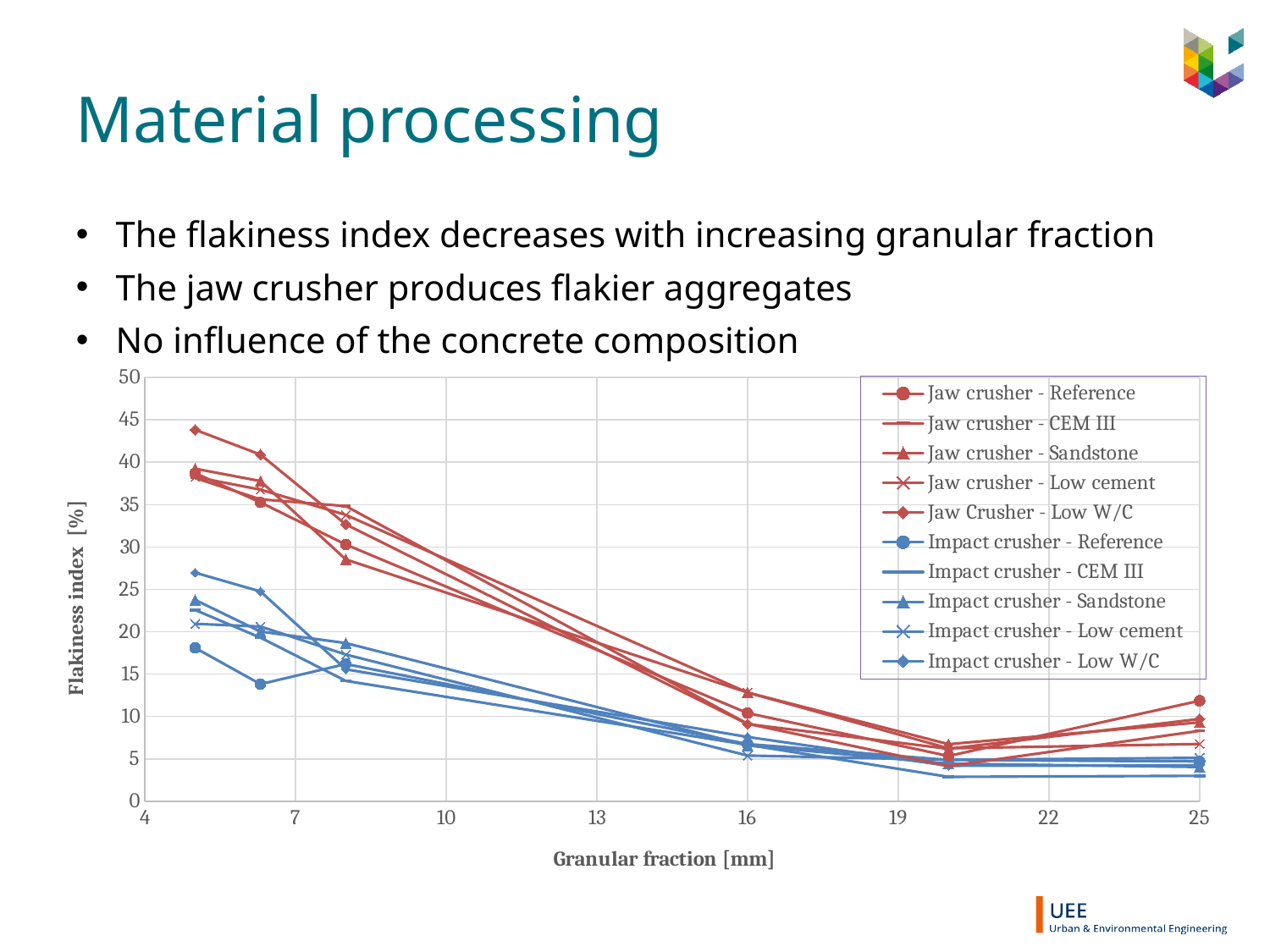
What kind of chart is shown on the slide? line chart At the smallest granular fraction, which series has the higher flakiness index: Jaw Crusher - Low W/C or Impact crusher - Reference? Jaw Crusher - Low W/C Is the value for Impact crusher - Reference at the smallest granular fraction greater or less than 20? less What is the label of the y axis? Flakiness index [%] How many series does the chart legend list? 10 Which series has the highest flakiness index at the smallest granular fraction? Jaw Crusher - Low W/C At a granular fraction of 16 mm, which series has the higher flakiness index: Jaw crusher - Sandstone or Impact crusher - Low cement? Jaw crusher - Sandstone What is the label of the x axis? Granular fraction [mm] Is the value for Jaw Crusher - Low W/C at the smallest granular fraction greater or less than 40? greater Is the value for Impact crusher - CEM III at a granular fraction of 25 mm greater or less than 5? less Do the flakiness index values generally rise or fall as the granular fraction increases along the x axis? fall